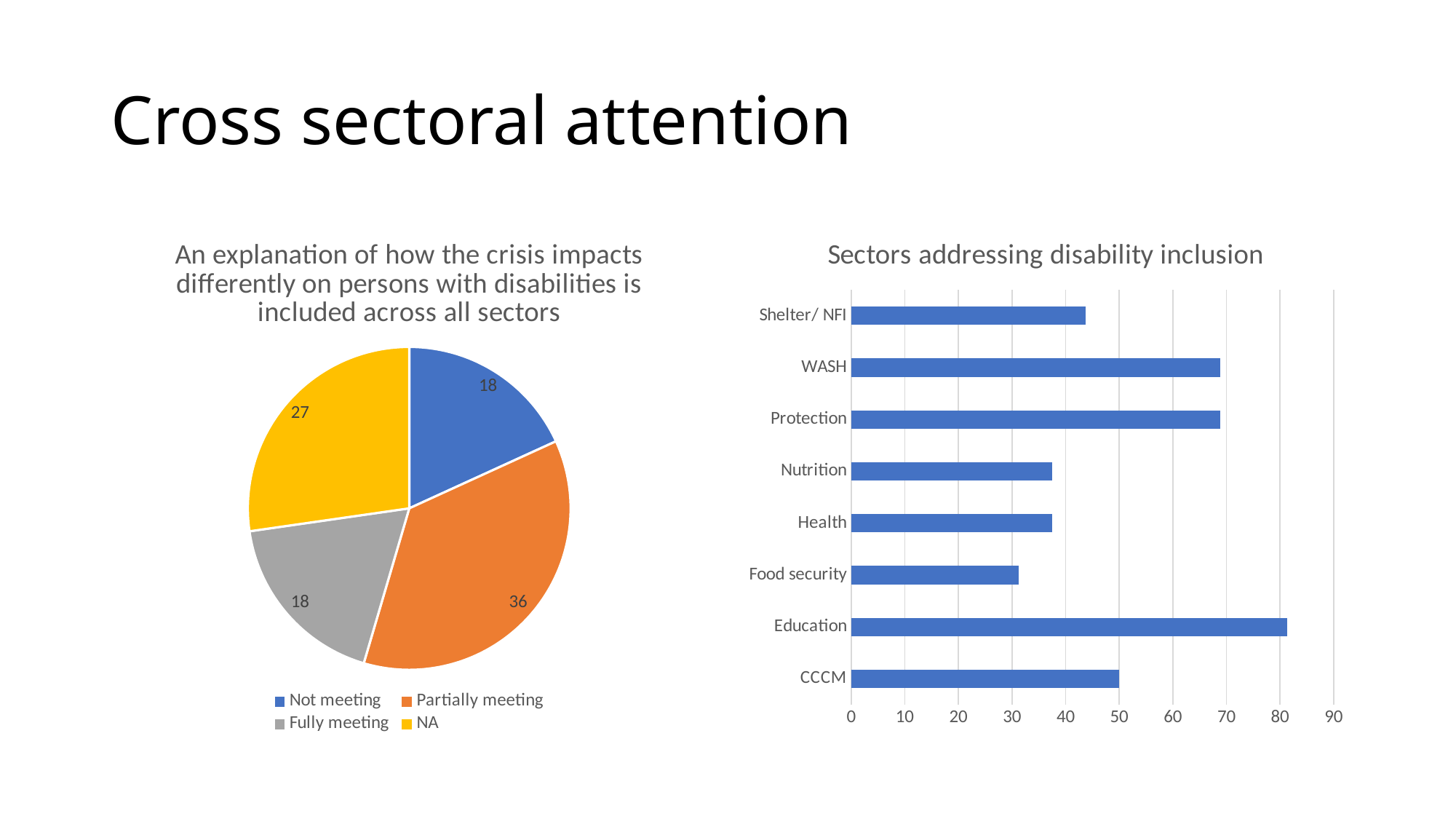
In the pie chart on the left, what is the difference between the 'Partially meeting' value and the 'Fully meeting' value? 18 In the pie chart on the left, which colour represents 'NA'? Yellow How many sectors are shown in the 'Sectors addressing disability inclusion' chart? 8 In the pie chart on the left, what value is shown for the 'Partially meeting' slice? 36 In the 'Sectors addressing disability inclusion' chart, which sector has the highest value? Education In the pie chart on the left, how many categories does the legend list? 4 In the pie chart on the left, what value is shown for the 'NA' slice? 27 In the pie chart on the left, which category has the largest slice? Partially meeting In the 'Sectors addressing disability inclusion' chart, is the value for Food security greater or less than 40? less In the 'Sectors addressing disability inclusion' chart, is the value for Education greater or less than 70? greater In the 'Sectors addressing disability inclusion' chart, which sector has the lowest value? Food security What kind of chart is 'Sectors addressing disability inclusion'? Bar chart